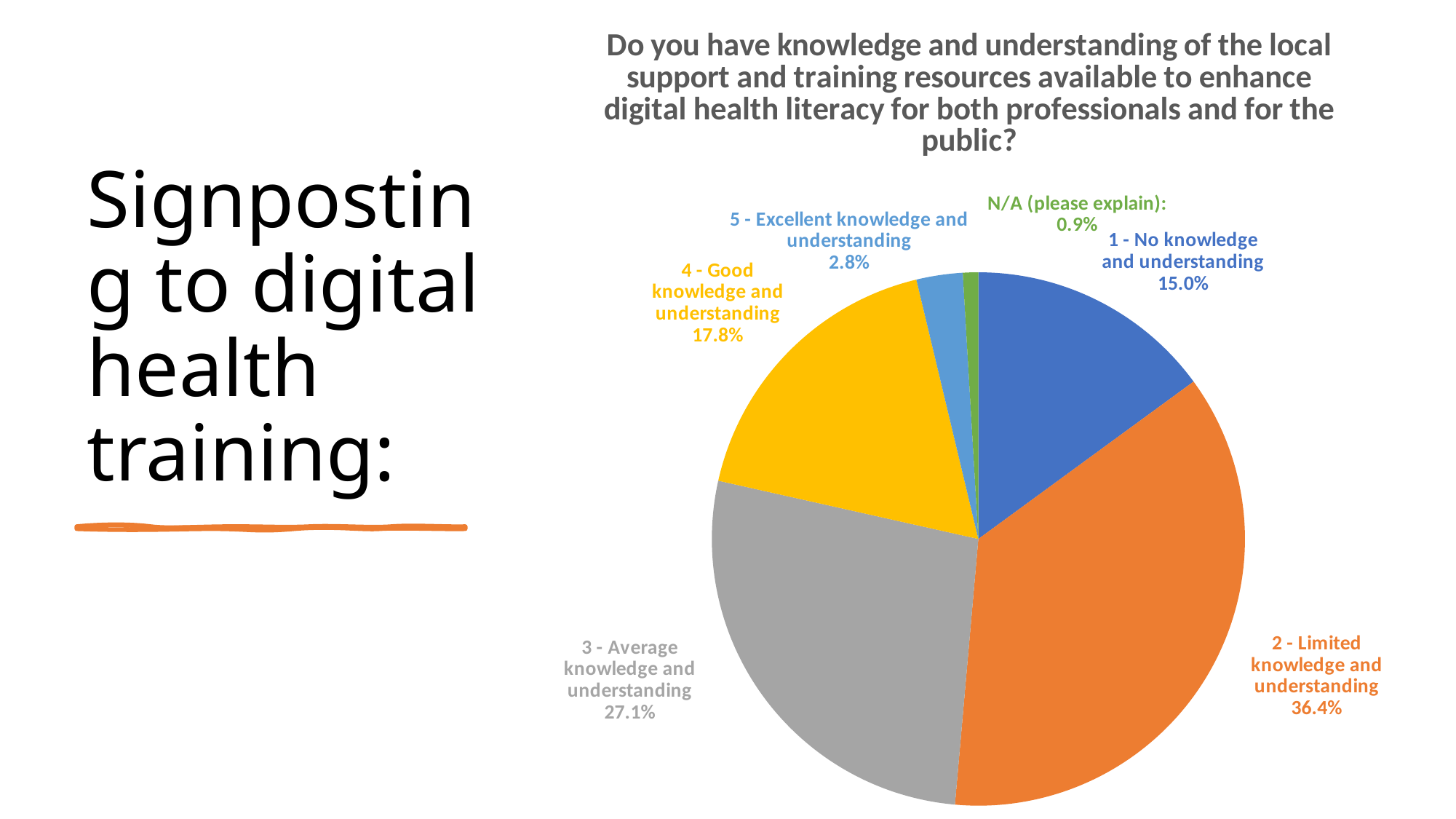
What share of the pie is '3 - Average knowledge and understanding'? 27.1% What kind of chart is shown on the slide? Pie chart What is the value for '4 - Good knowledge and understanding'? 17.8% Which category has the largest slice of the pie? 2 - Limited knowledge and understanding What is the value for '5 - Excellent knowledge and understanding'? 2.8% What is the difference between the shares for '2 - Limited knowledge and understanding' and '3 - Average knowledge and understanding'? 9.3% Which category has the smallest slice of the pie? N/A (please explain) What colour is the slice for '3 - Average knowledge and understanding'? Grey How many slices does the pie chart have? 6 What is the value for '1 - No knowledge and understanding'? 15.0% What share of the pie is '2 - Limited knowledge and understanding'? 36.4% Which is larger: the share for '4 - Good knowledge and understanding' or '1 - No knowledge and understanding'? 4 - Good knowledge and understanding